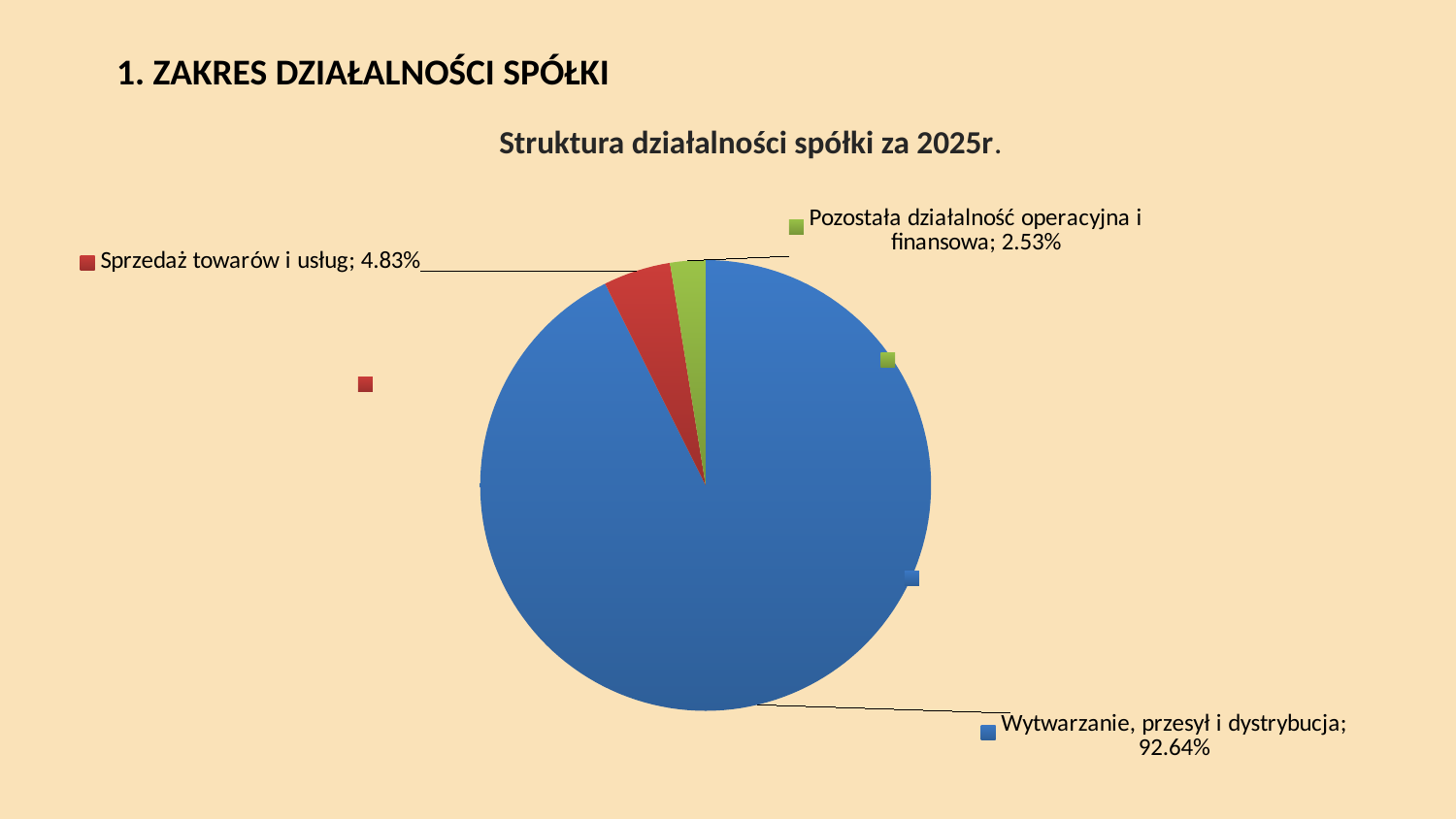
What is the difference between the shares of 'Sprzedaż towarów i usług' and 'Pozostała działalność operacyjna i finansowa'? 2.30% What kind of chart is shown on the slide? pie chart Which category has the smallest slice of the pie? Pozostała działalność operacyjna i finansowa What share of the pie is 'Pozostała działalność operacyjna i finansowa'? 2.53% Which category has the largest slice of the pie? Wytwarzanie, przesył i dystrybucja What is the title of the chart? Struktura działalności spółki za 2025r. What colour is the slice for 'Sprzedaż towarów i usług'? red What share of the pie is 'Wytwarzanie, przesył i dystrybucja'? 92.64% Which is larger: 'Sprzedaż towarów i usług' or 'Pozostała działalność operacyjna i finansowa'? Sprzedaż towarów i usług What share of the pie is 'Sprzedaż towarów i usług'? 4.83% How many slices does the pie chart have? 3 What is the difference between the shares of 'Wytwarzanie, przesył i dystrybucja' and 'Sprzedaż towarów i usług'? 87.81%